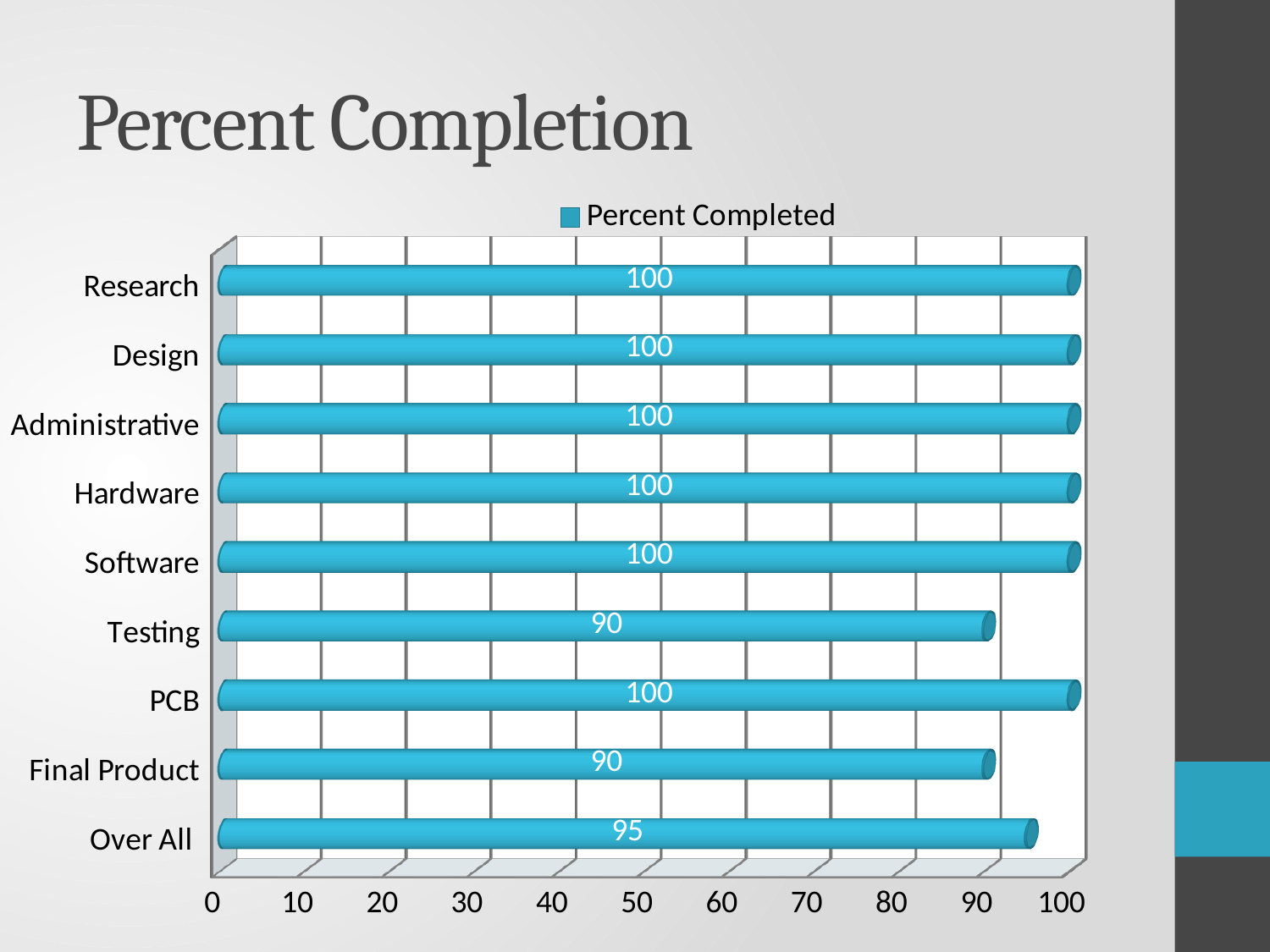
What is the Percent Completed value for Over All? 95 What is the Percent Completed value for Final Product? 90 What is the title of the slide? Percent Completion What is the difference between the Percent Completed values for Research and Testing? 10 What is the Percent Completed value for Testing? 90 What is the Percent Completed value for PCB? 100 How many series does the legend list? 1 Which categories have the lowest Percent Completed value? Testing and Final Product What kind of chart is shown on the slide? Bar chart How many categories are shown on the chart? 9 What is the difference between the Percent Completed values for Over All and Final Product? 5 Which is larger, the Percent Completed value for Software or for Over All? Software